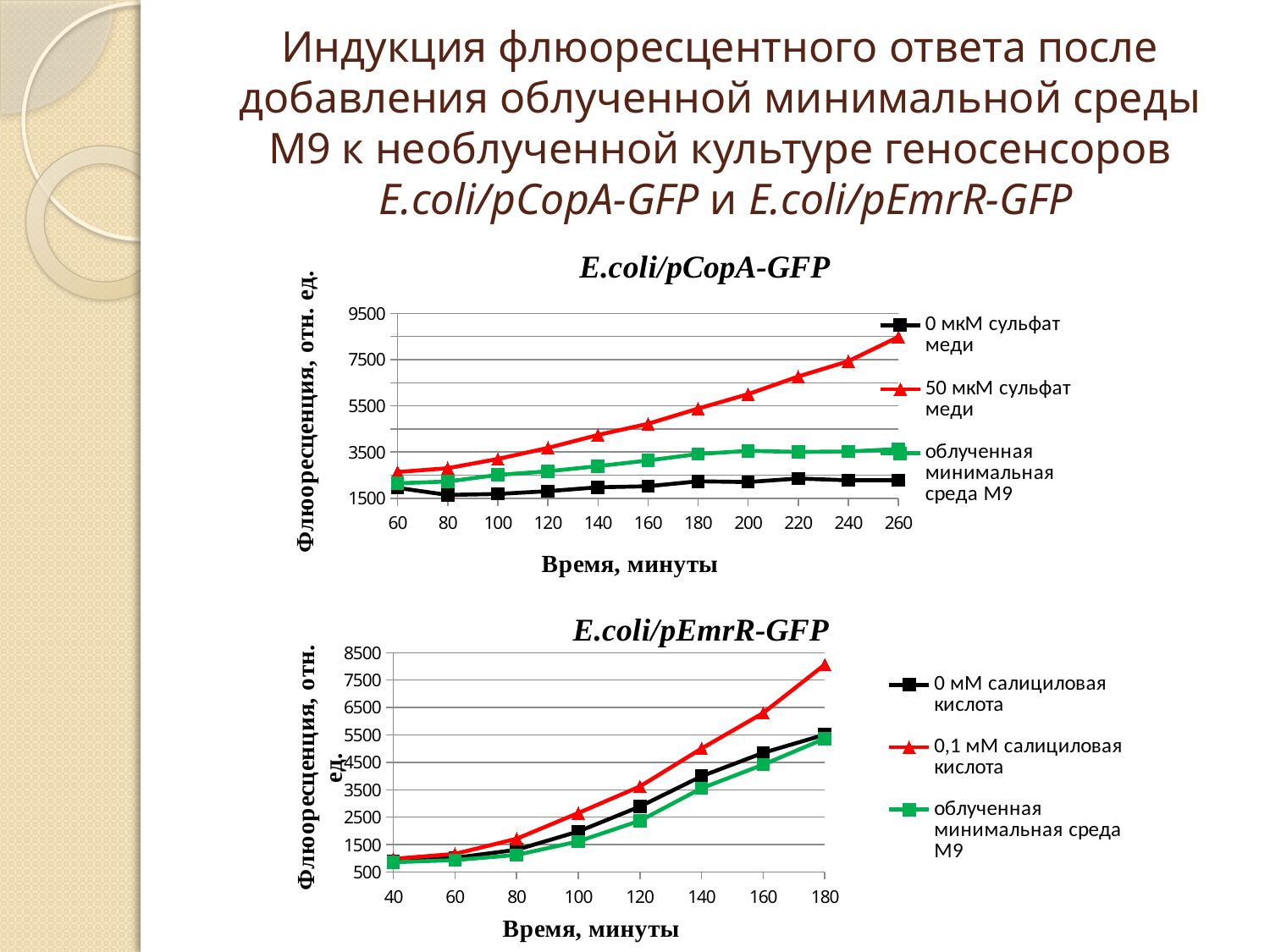
How many series does the legend of the E.coli/pEmrR-GFP chart list? 3 In the E.coli/pEmrR-GFP chart, is the value for 0,1 мМ салициловая кислота at 180 minutes greater or less than 7500? greater How many series does the legend of the E.coli/pCopA-GFP chart list? 3 How many time points are plotted along the x axis of the E.coli/pCopA-GFP chart? 11 In the E.coli/pCopA-GFP chart, is the value for облученная минимальная среда М9 at 260 minutes greater or less than 5500? less In the E.coli/pEmrR-GFP chart, which series is higher at 180 minutes: 0,1 мМ салициловая кислота or облученная минимальная среда М9? 0,1 мМ салициловая кислота In the E.coli/pCopA-GFP chart, which series is higher at 260 minutes: 50 мкМ сульфат меди or облученная минимальная среда М9? 50 мкМ сульфат меди What type of chart is the E.coli/pCopA-GFP chart? line chart In the E.coli/pCopA-GFP chart, does the 50 мкМ сульфат меди series rise or fall as time increases? rise What is the x-axis label of the E.coli/pEmrR-GFP chart? Время, минуты How many time points are plotted along the x axis of the E.coli/pEmrR-GFP chart? 8 In the E.coli/pCopA-GFP chart, is the value for 50 мкМ сульфат меди at 260 minutes greater or less than 7500? greater